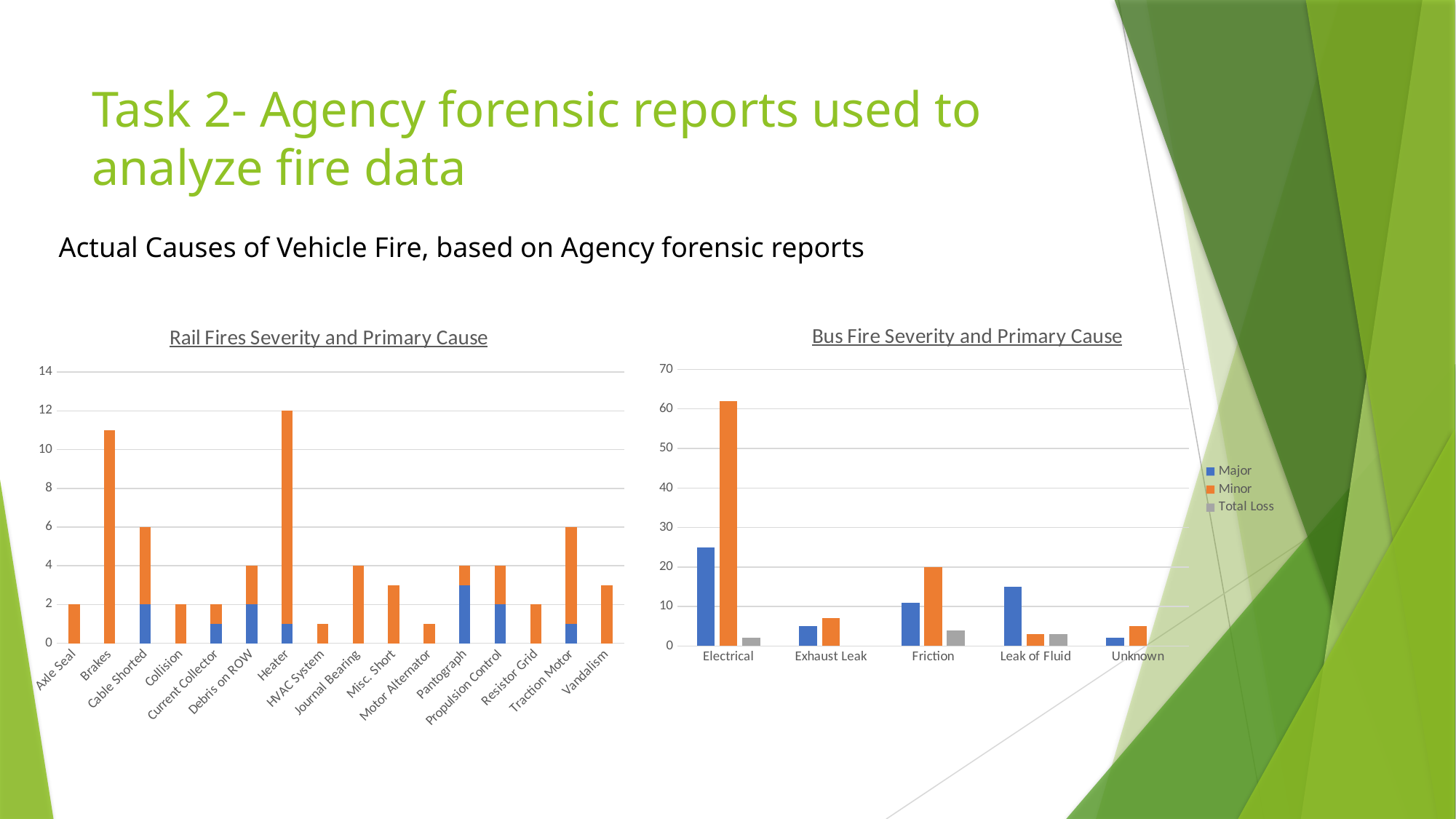
In the 'Bus Fire Severity and Primary Cause' chart, is the Minor value for Electrical greater or less than 60? greater In the 'Bus Fire Severity and Primary Cause' chart, what is the Minor value for Friction? 20 How many categories are shown on the x axis of the 'Rail Fires Severity and Primary Cause' chart? 16 In the 'Rail Fires Severity and Primary Cause' chart, what is the total height of the Heater bar? 12 How many categories are shown on the x axis of the 'Bus Fire Severity and Primary Cause' chart? 5 What kind of chart is the 'Rail Fires Severity and Primary Cause' chart? bar chart In the 'Rail Fires Severity and Primary Cause' chart, what is the total height of the Debris on ROW bar? 4 In the 'Bus Fire Severity and Primary Cause' chart, which category has the highest Minor value? Electrical How many series does the legend next to the 'Bus Fire Severity and Primary Cause' chart list? 3 In the 'Rail Fires Severity and Primary Cause' chart, which category has the tallest bar? Heater In the 'Bus Fire Severity and Primary Cause' chart, for Leak of Fluid, which is larger: Major or Minor? Major In the 'Rail Fires Severity and Primary Cause' chart, is the value for Brakes greater or less than 10? greater